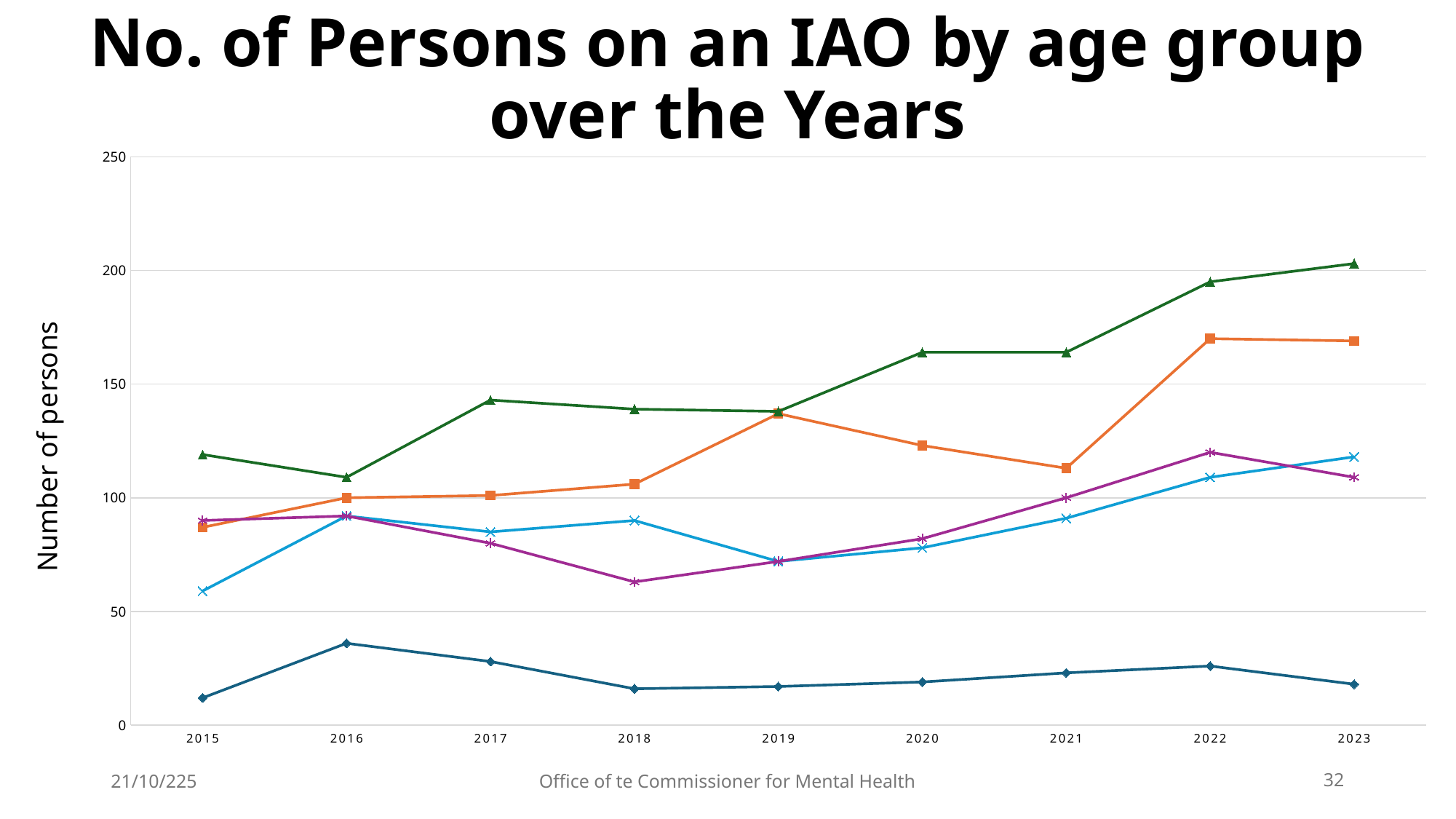
Is the value of the orange line with square markers in 2022 greater or less than 150? greater Is the value of the green line with triangle markers in 2020 greater or less than 150? greater What kind of chart is shown on the slide? line chart What is the label on the vertical axis of the chart? Number of persons Does the green line with triangle markers generally rise or fall from 2015 to 2023? rise Which line is the lowest across all years on the chart? the dark blue line with diamond markers Is the value of the dark blue line with diamond markers in 2016 greater or less than 50? less Which line has the highest value in 2023: the green line with triangle markers or the orange line with square markers? the green line with triangle markers What is the title of the chart? No. of Persons on an IAO by age group over the Years How many years are shown along the x axis of the chart? 9